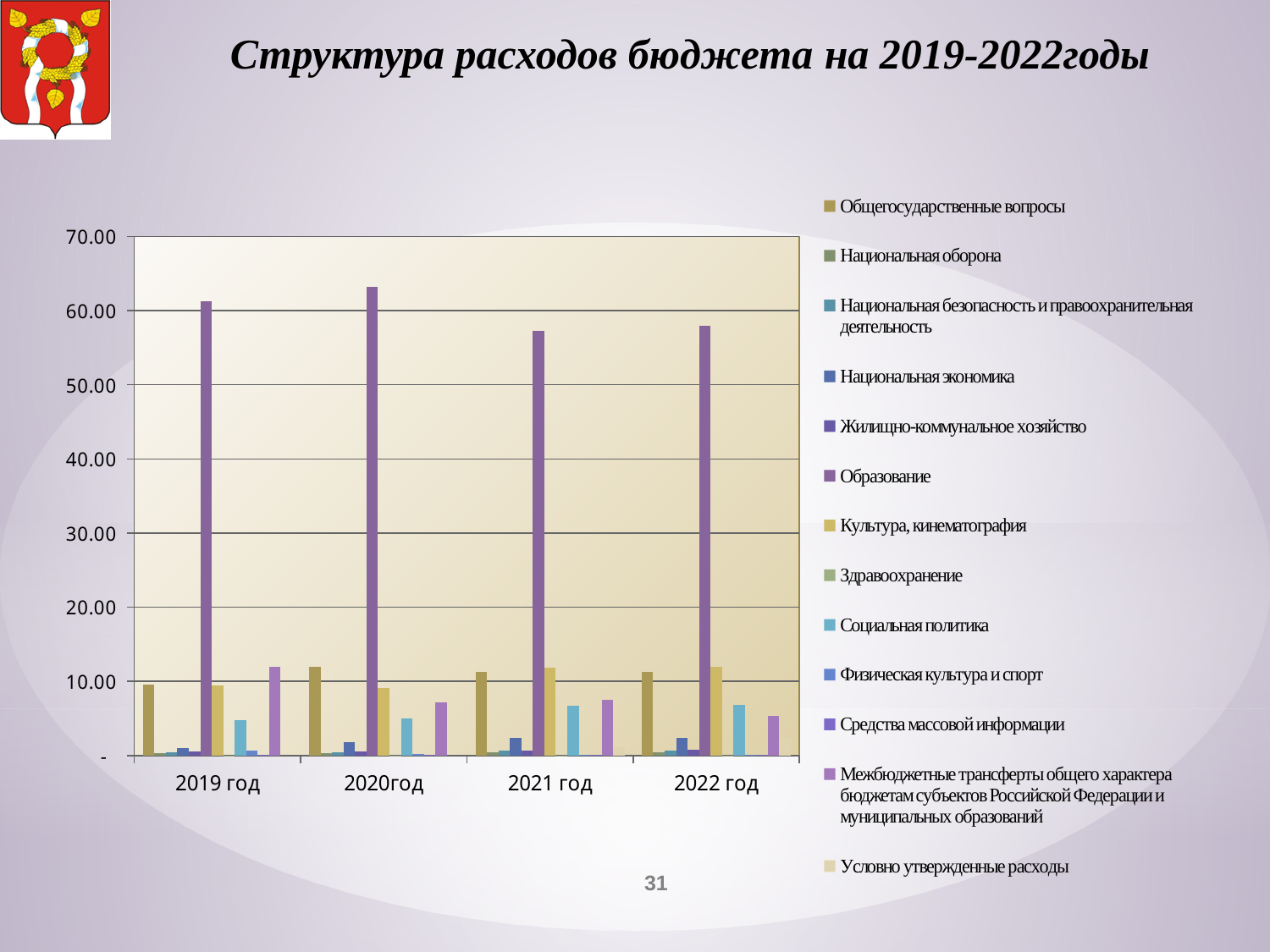
Is the value for Межбюджетные трансферты общего характера бюджетам субъектов Российской Федерации и муниципальных образований in 2022 год greater or less than 10.00? less What is the first entry listed in the chart legend? Общегосударственные вопросы Is the value for Образование in 2021 год greater or less than 60.00? less Is the value for Образование in 2019 год greater or less than 60.00? greater Which is larger: the value for Образование in 2020год or in 2021 год? 2020год What kind of chart is shown on the slide? bar chart In which year is the value for Образование the highest? 2020год Which series has the tallest bar in every year group? Образование What is the title of the slide's chart? Структура расходов бюджета на 2019-2022годы How many year categories are shown on the x axis of the chart? 4 How many series does the chart legend list? 13